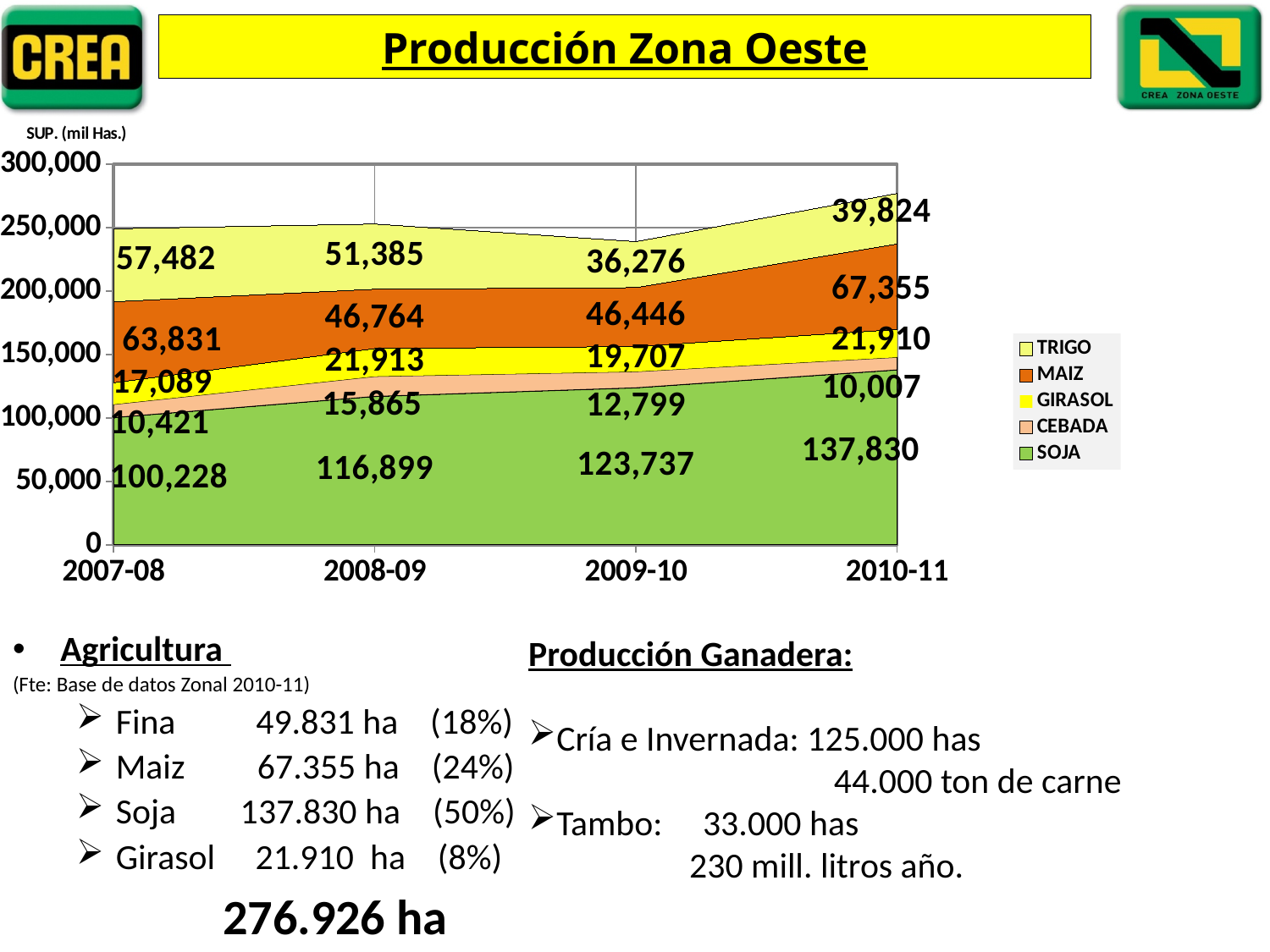
How many series does the legend list? 5 Which series has the smallest value in 2010-11? CEBADA What is the SOJA value for 2010-11? 137,830 Which series has the largest value in 2010-11? SOJA What kind of chart is shown? Stacked area chart What is the TRIGO value for 2007-08? 57,482 What is the CEBADA value for 2008-09? 15,865 How many periods are shown on the x axis? 4 What is the difference between the SOJA value in 2010-11 and in 2007-08? 37,602 What is the GIRASOL value for 2009-10? 19,707 Does the SOJA value rise or fall from 2007-08 to 2010-11? Rise In 2007-08, which is larger: MAIZ or TRIGO? MAIZ